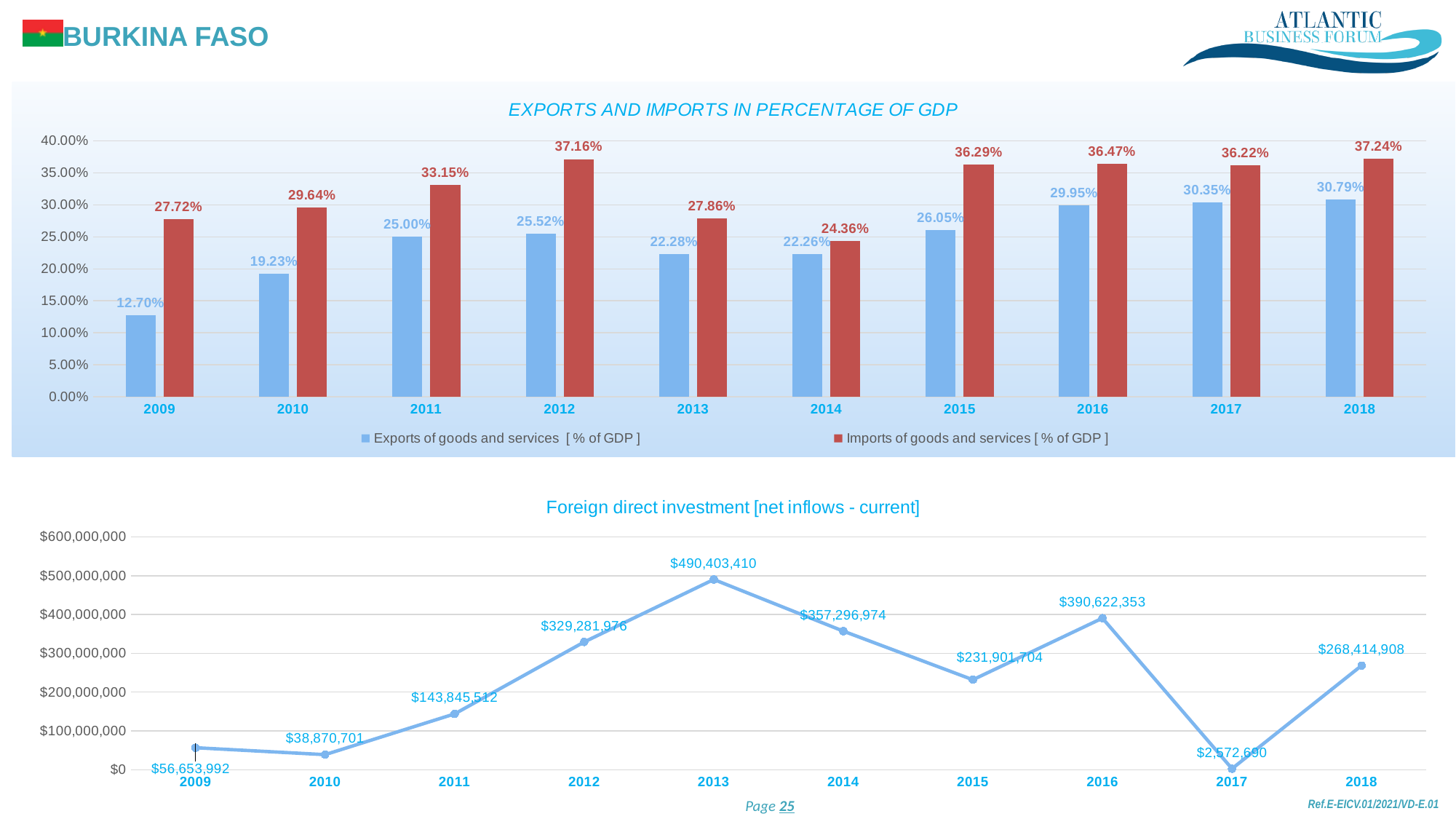
In the 'EXPORTS AND IMPORTS IN PERCENTAGE OF GDP' chart, which year has the highest imports value? 2018 In the 'Foreign direct investment [net inflows - current]' chart, which year has the lowest value? 2017 In the 'Foreign direct investment [net inflows - current]' chart, what is the value for 2013? $490,403,410 In the 'EXPORTS AND IMPORTS IN PERCENTAGE OF GDP' chart, which year has the lowest exports value? 2009 In the 'Foreign direct investment [net inflows - current]' chart, how many years are plotted? 10 In the 'EXPORTS AND IMPORTS IN PERCENTAGE OF GDP' chart, what is the value of imports of goods and services in 2012? 37.16% What kind of chart is the 'Foreign direct investment [net inflows - current]' chart? Line chart What kind of chart is the 'EXPORTS AND IMPORTS IN PERCENTAGE OF GDP' chart? Bar chart In the 'Foreign direct investment [net inflows - current]' chart, what is the difference between the 2013 and 2014 values? $133,106,436 In the 'EXPORTS AND IMPORTS IN PERCENTAGE OF GDP' chart, what is the value of exports of goods and services in 2009? 12.70% In the 'EXPORTS AND IMPORTS IN PERCENTAGE OF GDP' chart, how many series does the legend list? 2 In the 'EXPORTS AND IMPORTS IN PERCENTAGE OF GDP' chart, what is the difference between imports and exports in 2012? 11.64%